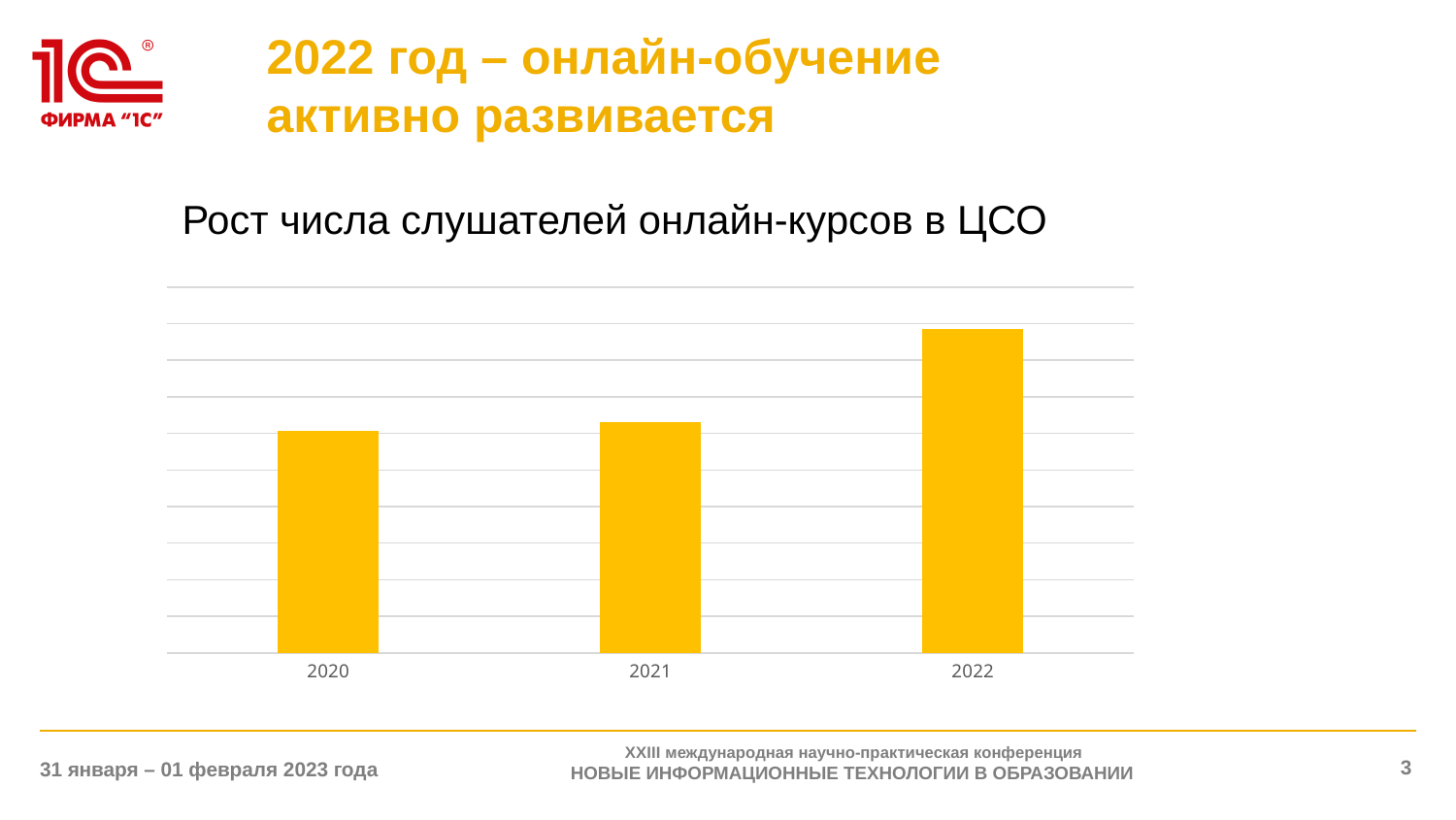
What kind of chart is shown on the slide? bar chart What is the last year shown on the x axis? 2022 Which bar is taller, 2020 or 2021? 2021 Which bar is taller, 2021 or 2022? 2022 Which year has the highest bar in the chart? 2022 What is the first year shown on the x axis? 2020 What is the title of the chart? Рост числа слушателей онлайн-курсов в ЦСО Do the values rise or fall from 2020 to 2022? rise How many categories (years) are shown on the x axis of the chart? 3 Which year has the lowest bar in the chart? 2020 What colour are the bars in the chart? yellow